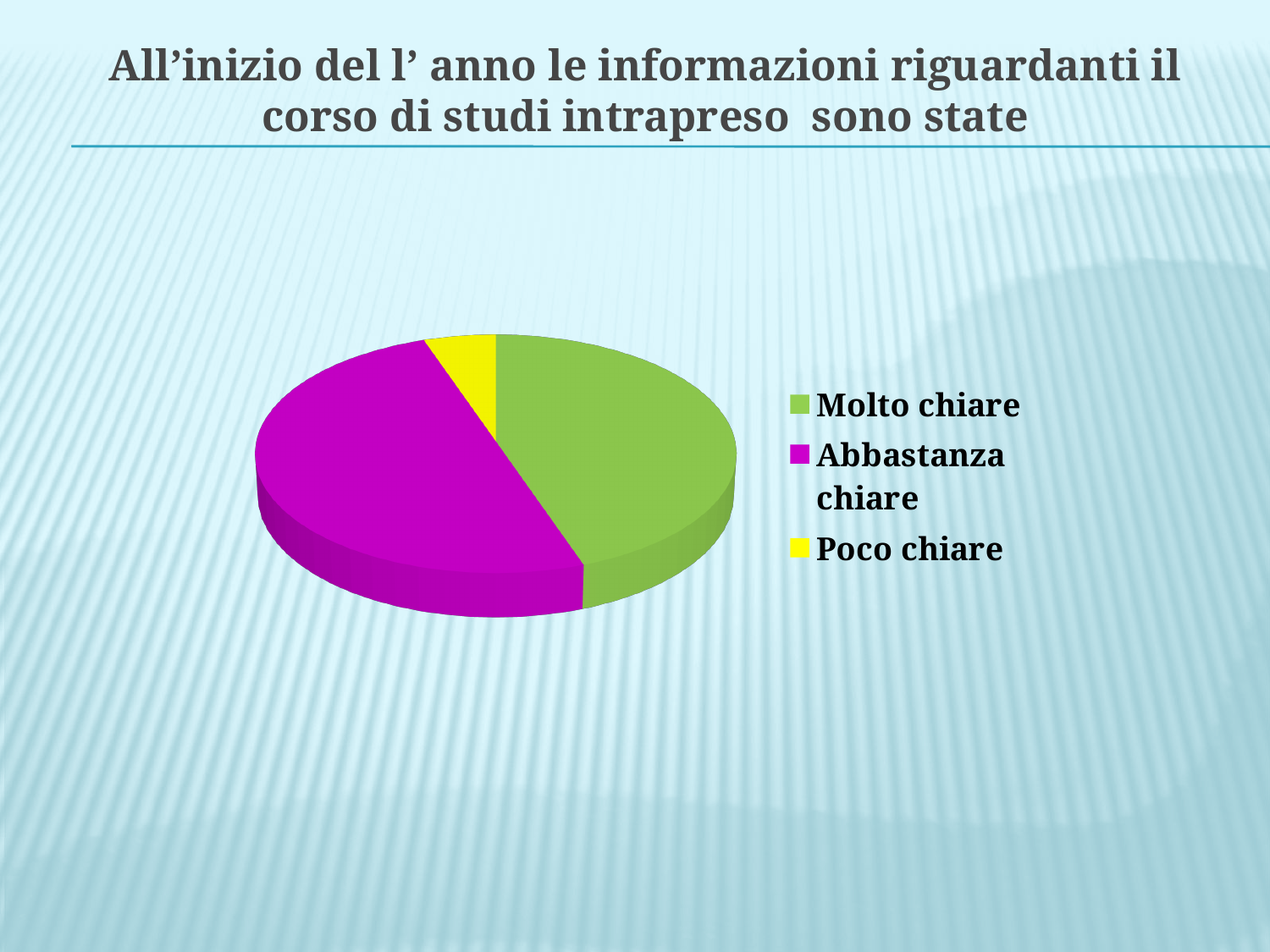
What colour is the Poco chiare slice in the pie chart? yellow How many slices does the pie chart have? 3 Which slice is larger, Abbastanza chiare or Poco chiare? Abbastanza chiare Which slice is larger, Poco chiare or Molto chiare? Molto chiare How many entries does the legend of the pie chart list? 3 Which category has the smallest slice in the pie chart? Poco chiare Which category is shown in green in the pie chart? Molto chiare What kind of chart is shown on the slide? pie chart